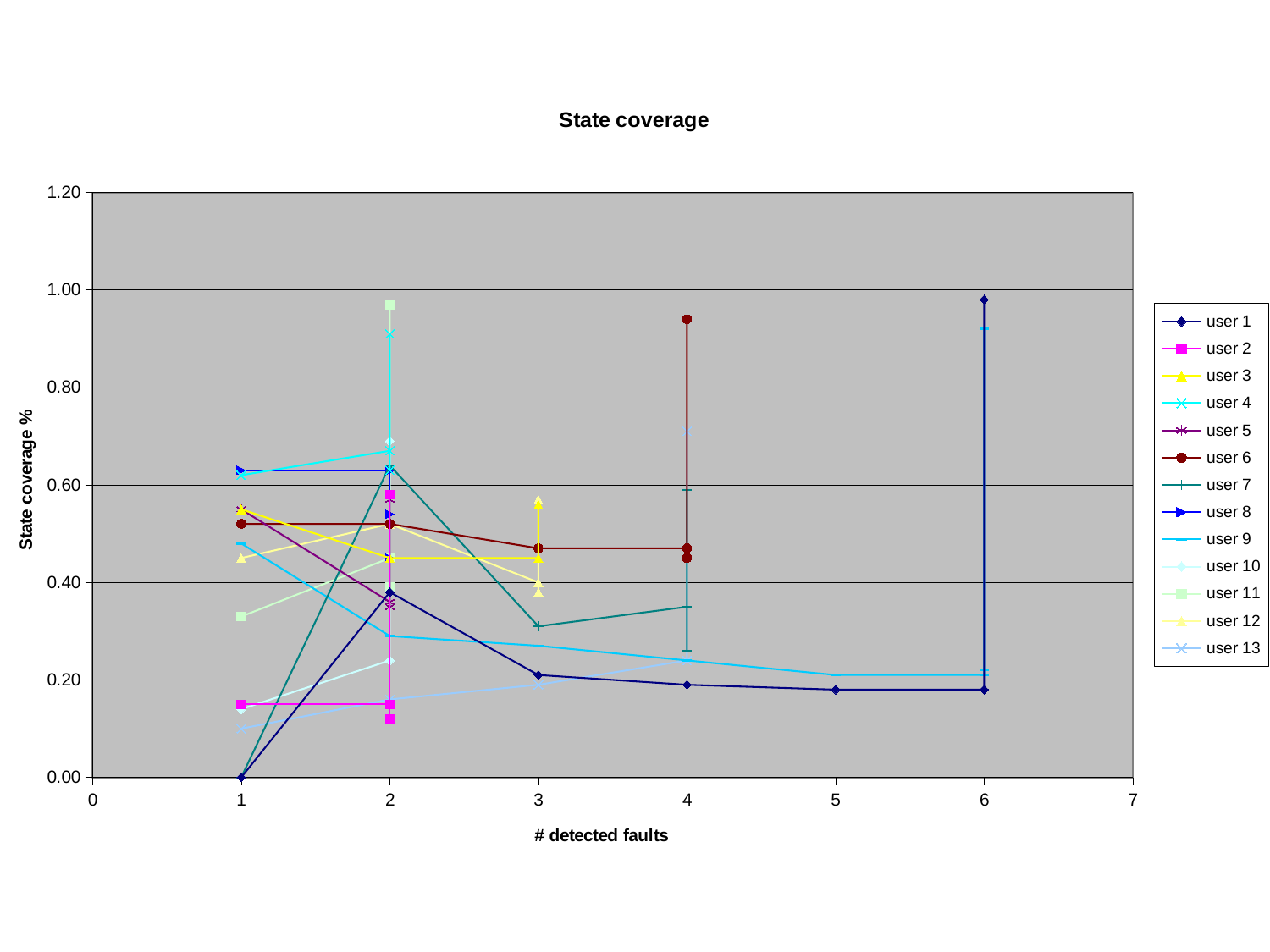
Is the value for user 2 at 1 detected fault greater or less than 0.20? less Is the value for user 1 at 6 detected faults (the upper point) greater or less than 0.80? greater Does the value for user 9 rise or fall from 1 detected fault to 5 detected faults? fall What is the title of the chart? State coverage What is the label of the x axis? # detected faults Is the value for user 7 at 3 detected faults greater or less than 0.40? less How many series does the legend list? 13 What kind of chart is shown on the slide? line chart